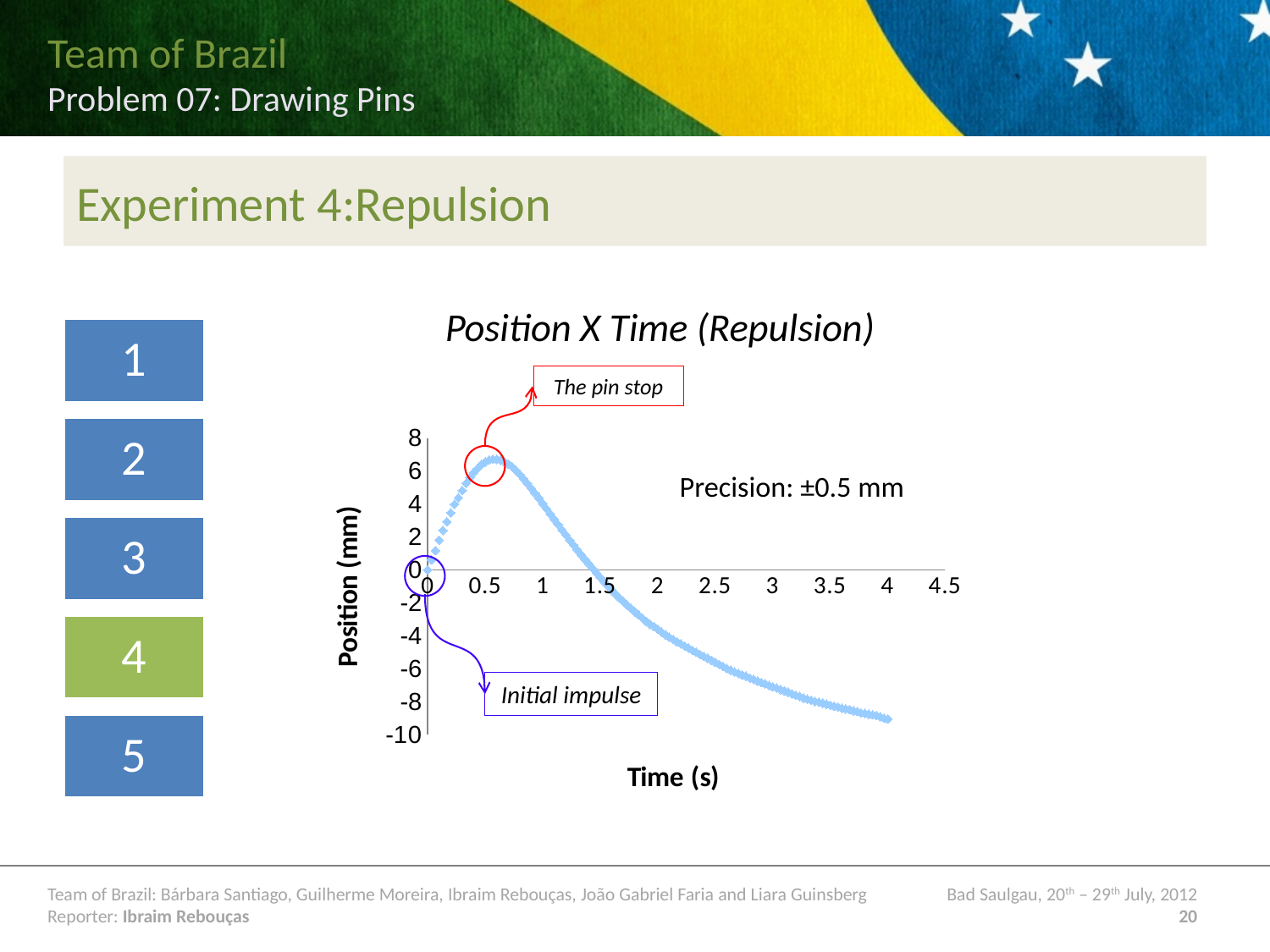
Is the position value at the last plotted point (around 4 s) greater or less than -8 mm? less Is the position value at time 3 s greater or less than -4 mm? less Is the position value at time 1 s greater or less than 2 mm? greater What kind of chart is shown on the slide? scatter chart What is the label of the vertical axis of the chart? Position (mm) After the peak near 0.5 s, do the position values rise or fall as time increases? fall What is the title of the chart? Position X Time (Repulsion) Which of the two values is larger: the position at time 1 s or the position at time 3 s? the position at time 1 s Between time 0 and the peak near 0.5 s, do the position values rise or fall? rise